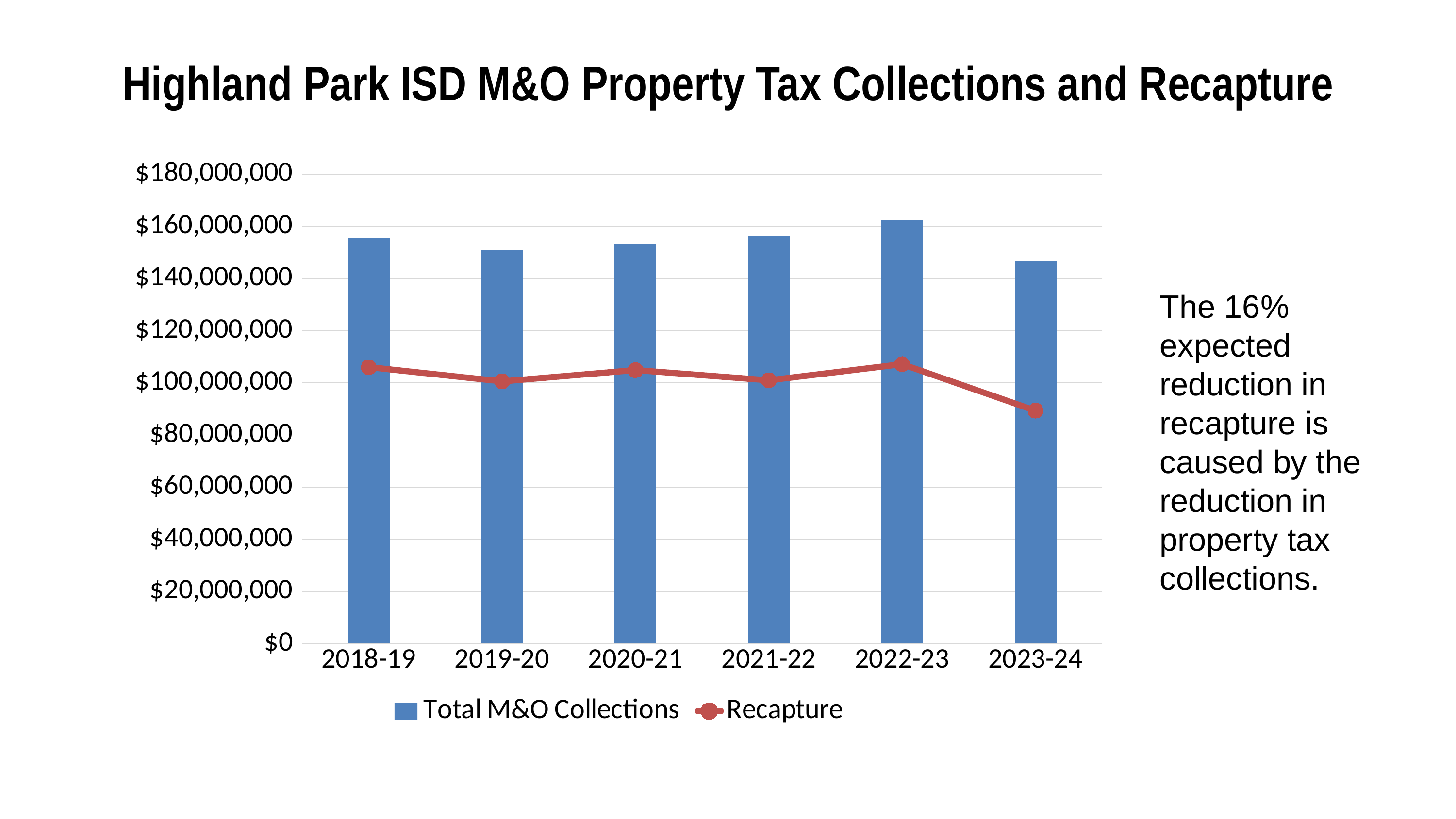
Is the Total M&O Collections value for 2022-23 greater or less than $160,000,000? greater Is the Recapture value for 2023-24 greater or less than $100,000,000? less Which year has the highest Total M&O Collections? 2022-23 Is the Total M&O Collections value for 2023-24 greater or less than $150,000,000? less Which is larger, Total M&O Collections in 2018-19 or in 2019-20? 2018-19 Which series is drawn as a line with markers? Recapture How many series does the legend list? 2 Which year has the lowest Total M&O Collections? 2023-24 What kind of chart is shown on the slide? A combined bar and line chart Which year has the lowest Recapture value? 2023-24 Does the Recapture line rise or fall from 2022-23 to 2023-24? Fall How many school years are shown on the x axis? 6